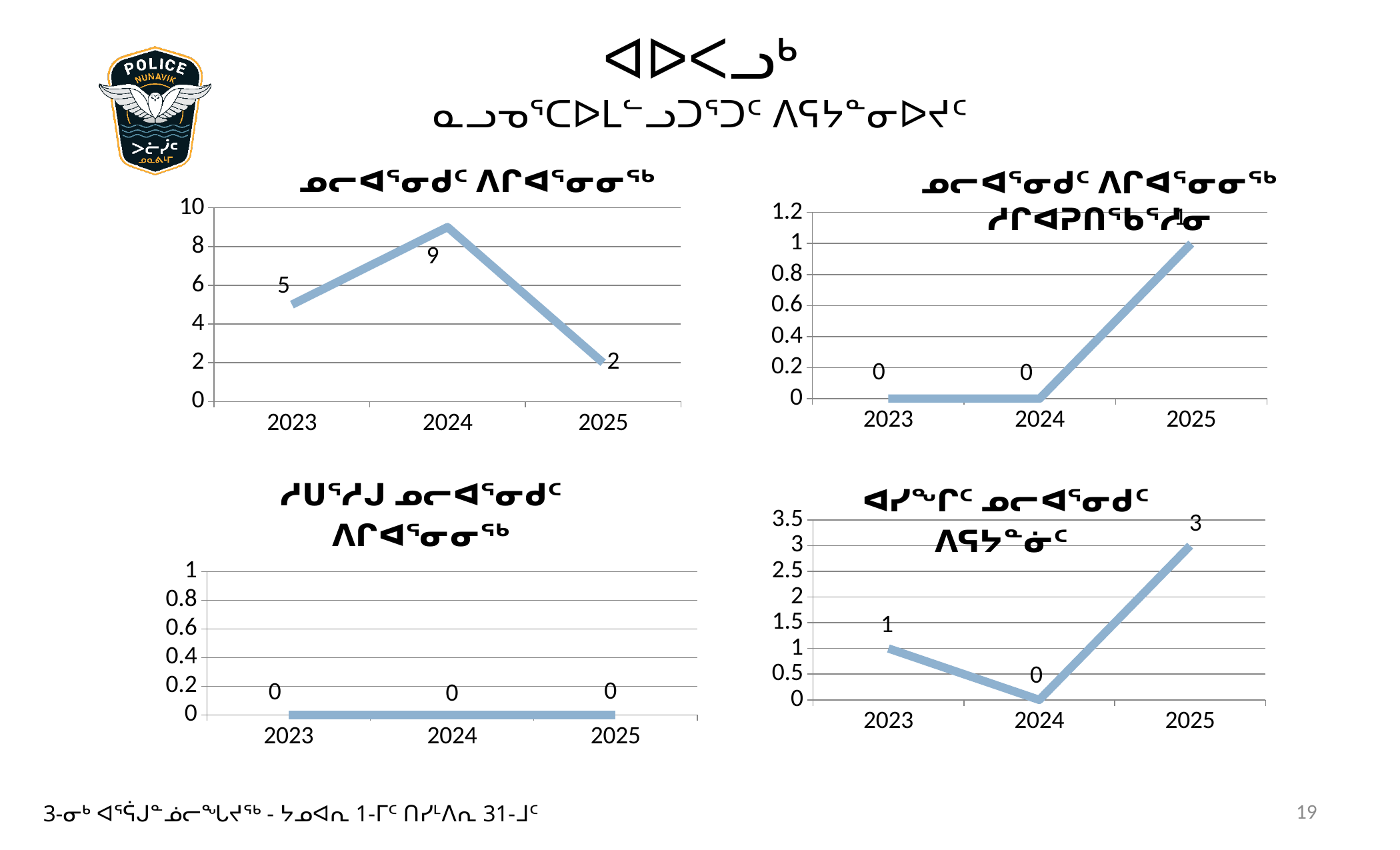
In the top-left chart, what is the difference between the 2024 and 2023 values? 4 In the top-right chart, which year has the highest value? 2025 In the top-left chart, what is the value for 2025? 2 In the top-right chart, what is the value for 2024? 0 In the bottom-right chart, which year has the lowest value? 2024 In the bottom-right chart, what is the value for 2025? 3 In the bottom-left chart, what is the value for 2025? 0 In the top-left chart, which year has the highest value? 2024 How many charts are on the slide, and what type are they? 4 line charts In the top-left chart, does the value rise or fall from 2024 to 2025? fall In the top-left chart, what is the value for 2024? 9 In the bottom-right chart, which is larger, the value for 2023 or the value for 2025? 2025